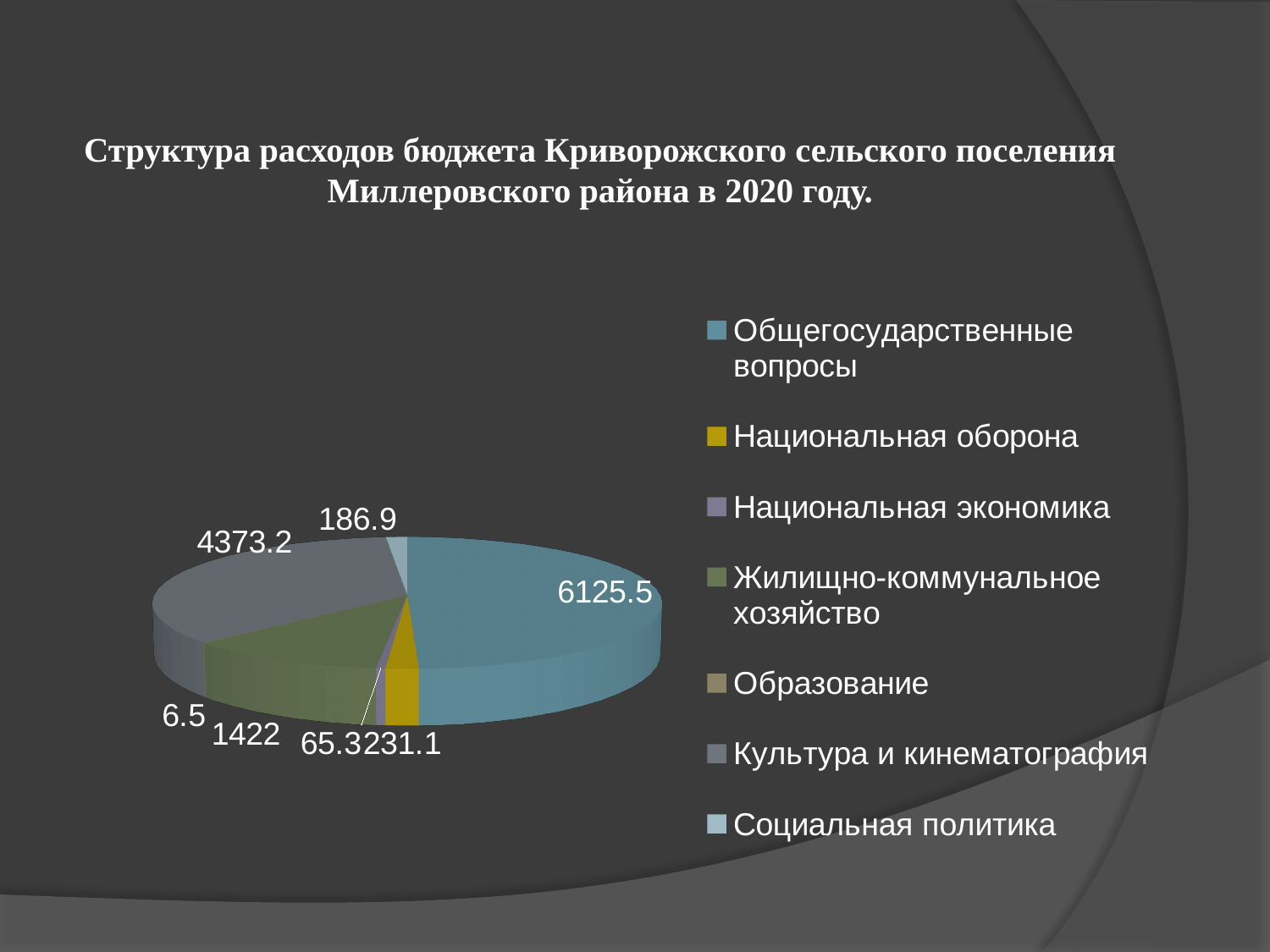
What is the value for Образование? 6.5 What is the value for Жилищно-коммунальное хозяйство? 1422 What is the value for Общегосударственные вопросы? 6125.5 Which category has the smallest slice of the pie? Образование What is the value for Культура и кинематография? 4373.2 How many categories does the legend list? 7 What is the difference between the values for Общегосударственные вопросы and Культура и кинематография? 1752.3 What kind of chart is shown on the slide? pie chart Which is larger, the value for Жилищно-коммунальное хозяйство or the value for Социальная политика? Жилищно-коммунальное хозяйство How many slices does the pie chart have? 7 What is the value for Социальная политика? 186.9 Which category has the largest slice of the pie? Общегосударственные вопросы